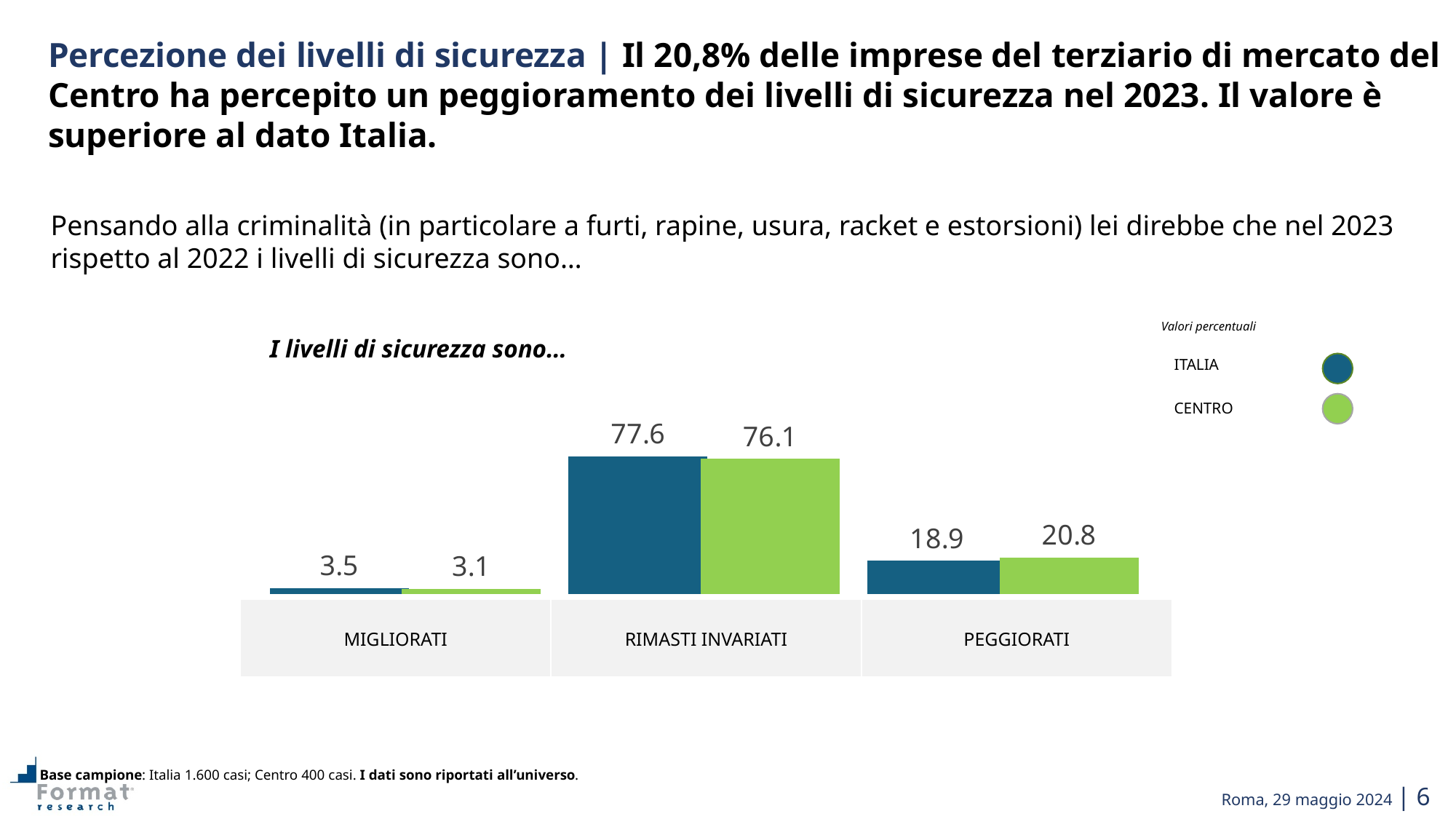
For PEGGIORATI, which is larger: the ITALIA value or the CENTRO value? CENTRO How many categories are shown on the x axis? 3 What is the CENTRO value for PEGGIORATI? 20.8 What is the ITALIA value for MIGLIORATI? 3.5 What is the difference between the CENTRO and ITALIA values for PEGGIORATI? 1.9 What kind of chart is shown on the slide? Bar chart How many series does the legend list? 2 What is the CENTRO value for MIGLIORATI? 3.1 Which category has the lowest ITALIA value? MIGLIORATI Which category has the highest CENTRO value? RIMASTI INVARIATI What is the ITALIA value for RIMASTI INVARIATI? 77.6 What is the difference between the ITALIA and CENTRO values for RIMASTI INVARIATI? 1.5